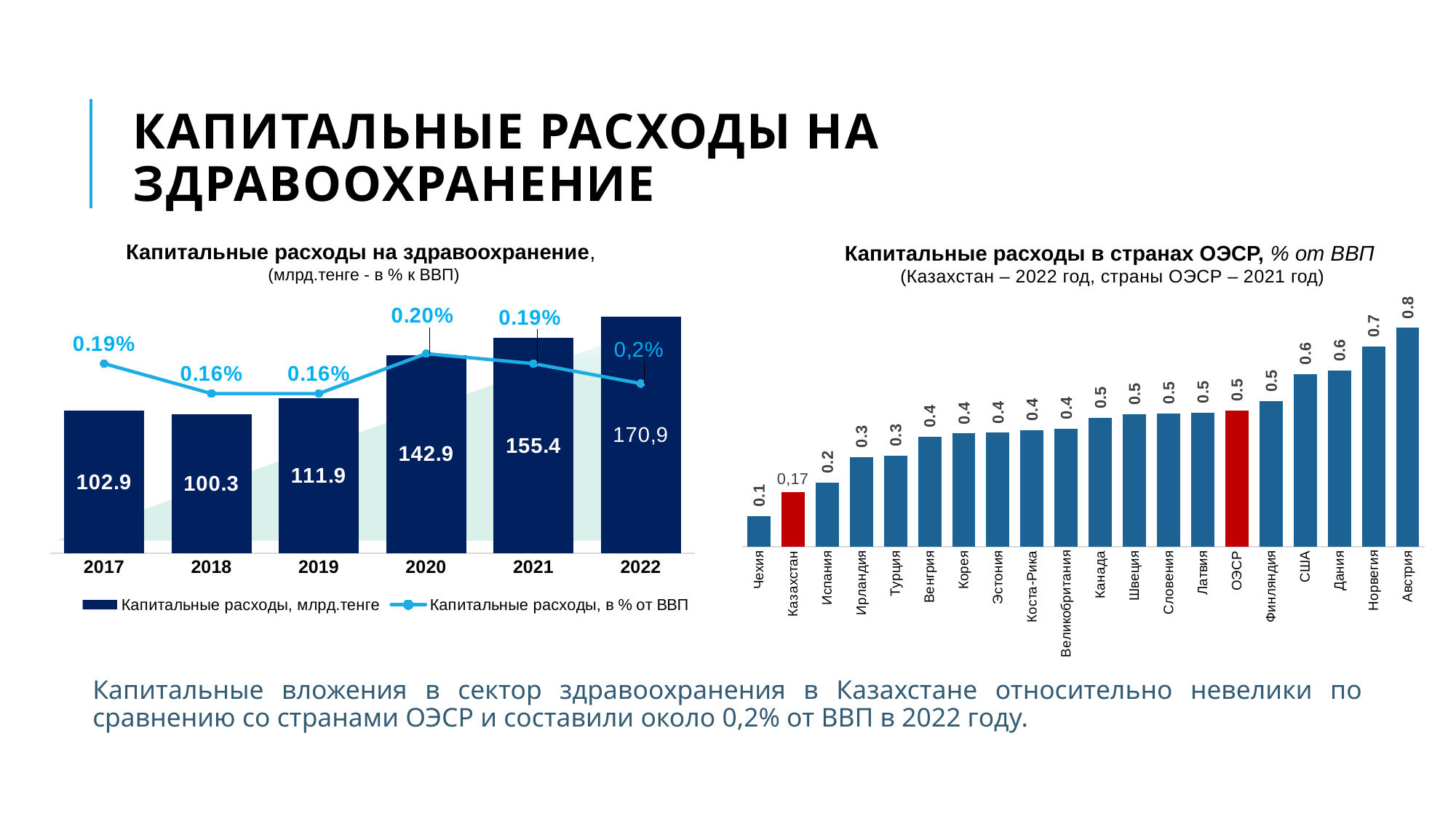
In the right chart 'Капитальные расходы в странах ОЭСР', which is larger, the value for Норвегия or the value for США? Норвегия In the left chart 'Капитальные расходы на здравоохранение', which year has the lowest capital expenditure in billion tenge? 2018 In the left chart 'Капитальные расходы на здравоохранение', what is the difference in billion tenge between 2022 and 2021? 15.5 In the right chart 'Капитальные расходы в странах ОЭСР', what is the value for Казахстан? 0,17 In the left chart 'Капитальные расходы на здравоохранение', what is the capital expenditure as % of GDP for 2018? 0.16% In the right chart 'Капитальные расходы в странах ОЭСР', which country has the highest value? Австрия In the left chart 'Капитальные расходы на здравоохранение', what is the value of capital expenditure in billion tenge for 2020? 142.9 In the left chart 'Капитальные расходы на здравоохранение', how many series does the legend list? 2 In the right chart 'Капитальные расходы в странах ОЭСР', what is the value for ОЭСР? 0.5 In the right chart 'Капитальные расходы в странах ОЭСР', which country has the lowest value? Чехия In the left chart 'Капитальные расходы на здравоохранение', do the bar values generally rise or fall from 2019 to 2022? rise In the right chart 'Капитальные расходы в странах ОЭСР', how many bars are shown? 20